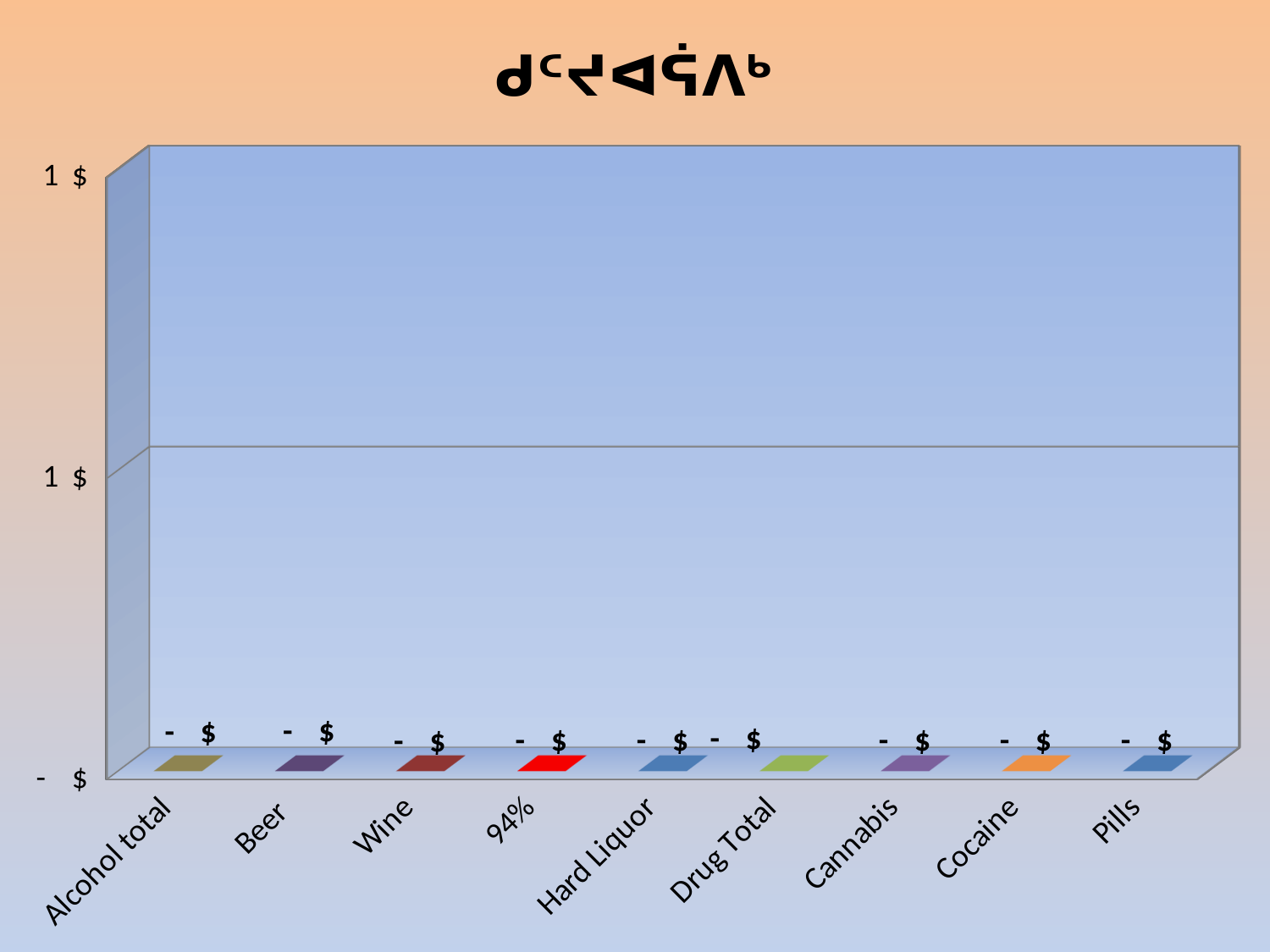
What kind of chart is shown on the slide? bar chart Is the value for Alcohol total greater or less than 1 $? less What is the data label shown above the bar for Drug Total? - $ Is the value for Hard Liquor greater or less than 1 $? less Which category label appears first (leftmost) on the x axis? Alcohol total What is the data label shown above the bar for Pills? - $ How many categories are shown along the x axis of the chart? 9 What is the data label shown above the bar for Beer? - $ What is the data label shown above the bar for Cannabis? - $ Is the value for Cocaine greater or less than 1 $? less What colour is the bar for Cocaine? orange